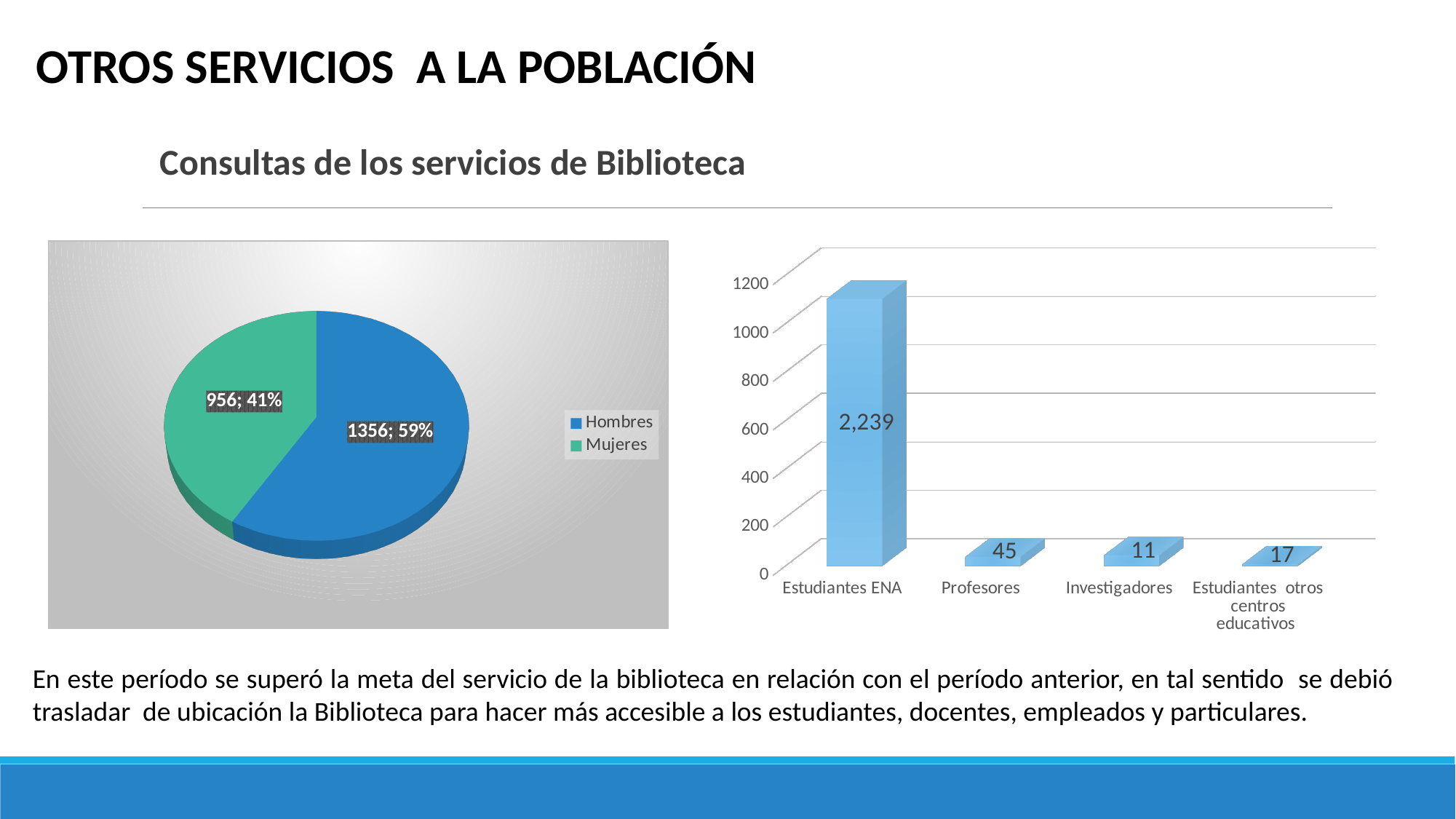
In the bar chart on the right, what is the value for Estudiantes ENA? 2,239 In the pie chart on the left, what is the difference between the Hombres and Mujeres values? 400 In the pie chart on the left, which slice is larger, Hombres or Mujeres? Hombres In the pie chart on the left, what share of the pie does Mujeres represent? 41% In the bar chart on the right, what is the value for Profesores? 45 In the bar chart on the right, which category has the highest value? Estudiantes ENA In the bar chart on the right, what is the difference between the values for Profesores and Estudiantes otros centros educativos? 28 How many categories are shown in the bar chart on the right? 4 What kind of chart is the chart on the left? Pie chart How many entries does the legend of the pie chart on the left list? 2 In the pie chart on the left, what value is shown for Hombres? 1356; 59%